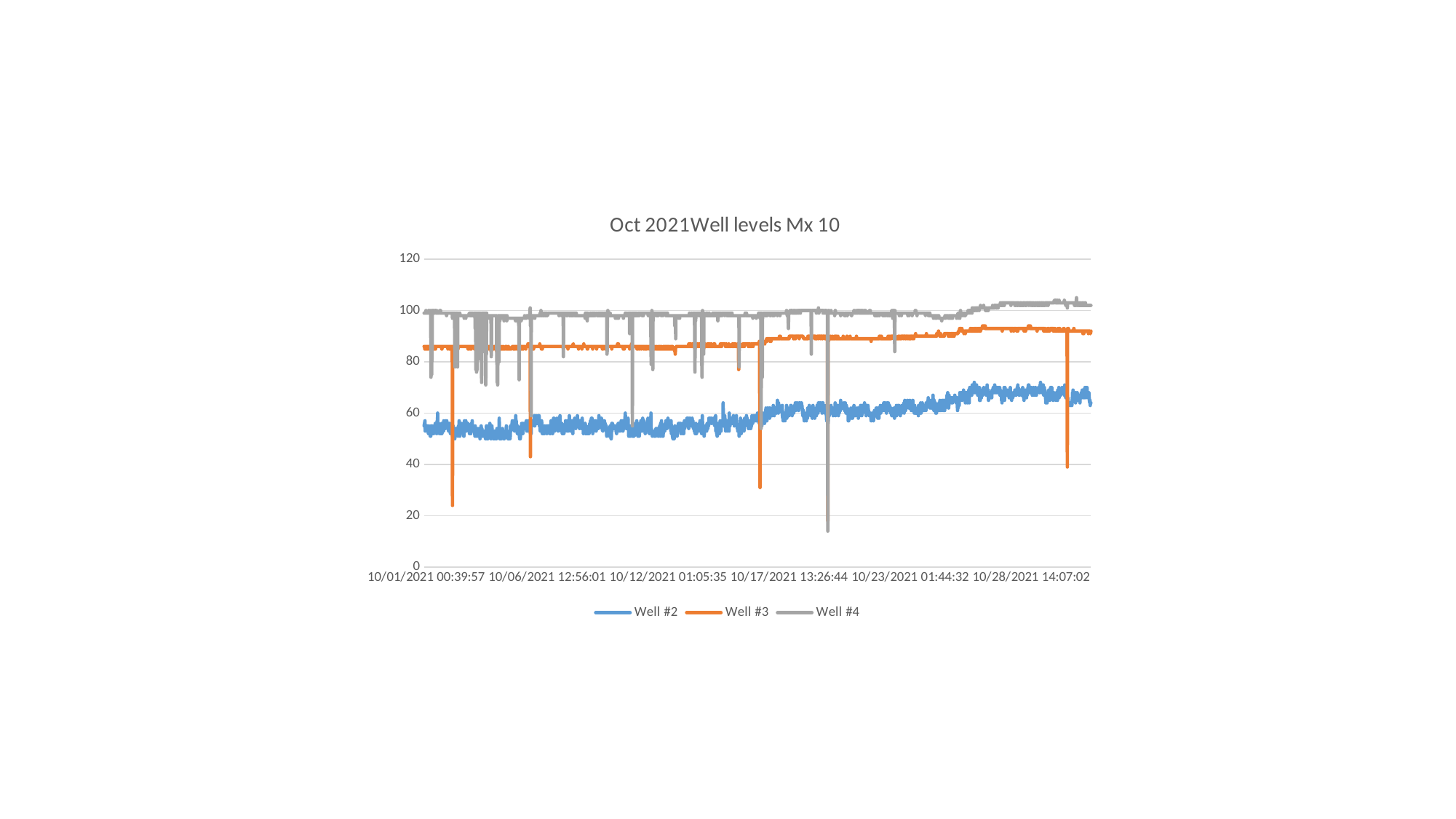
Which series are listed in the legend? Well #2, Well #3, Well #4 Is the value for Well #2 at the end of the period greater or less than 40? greater Is the typical value for Well #4 greater or less than 80? greater What is the title of the chart? Oct 2021Well levels Mx 10 Which series is generally larger, Well #3 or Well #2? Well #3 Which series generally has the lowest values across the period? Well #2 Is the value for Well #2 at the start of the period greater or less than 80? less Which series generally has the highest values across the period? Well #4 What kind of chart is shown on the slide? line chart How many series does the legend list? 3 Does the Well #2 line generally rise or fall from left to right? rise What is the maximum value shown on the vertical axis? 120